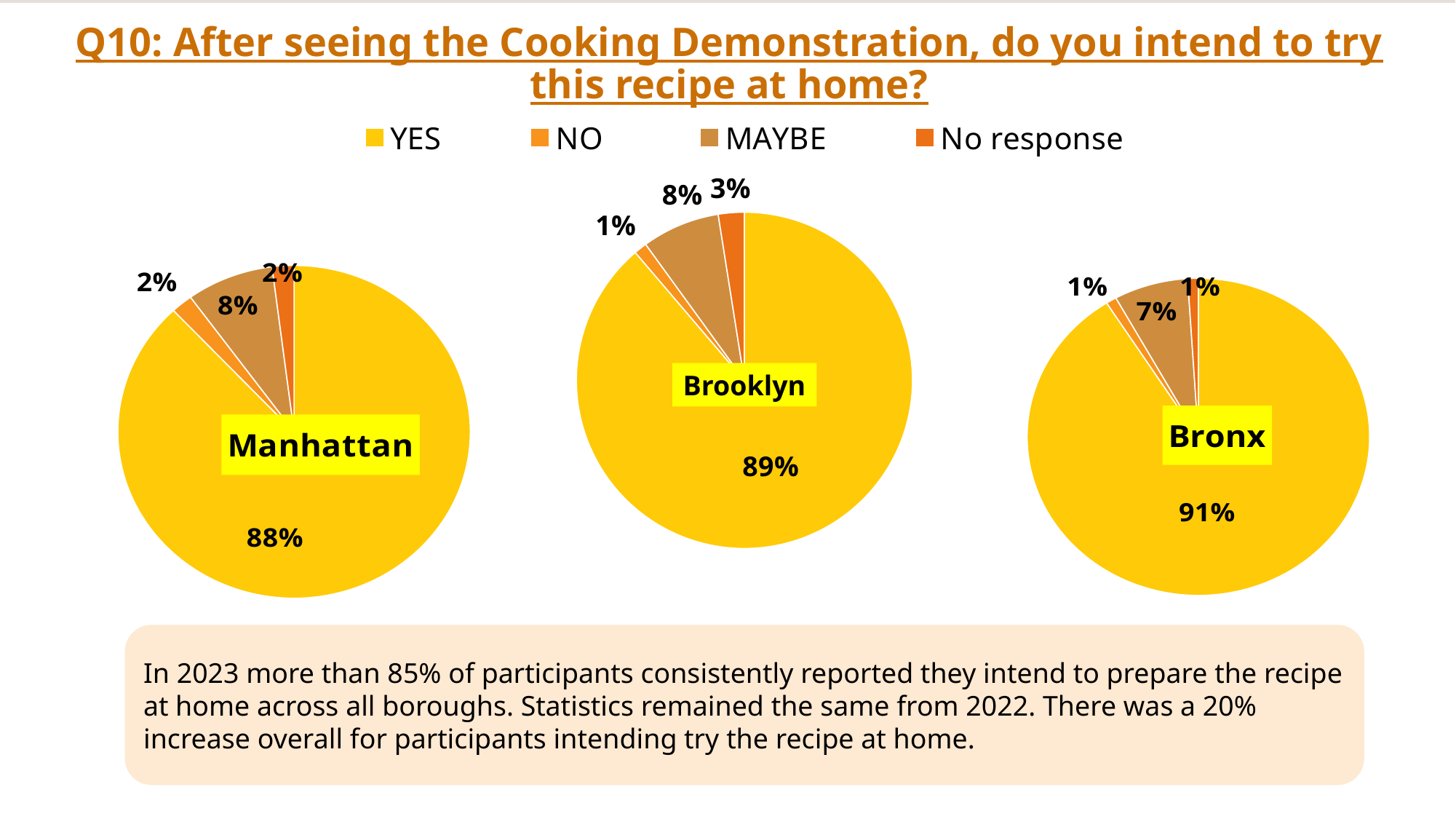
In the Brooklyn pie chart, what share of participants gave No response? 3% What kind of charts are shown on the slide? Pie charts In the Bronx pie chart, what share of participants answered MAYBE? 7% In the Bronx pie chart, what share of participants answered YES? 91% In the Manhattan pie chart, what share of participants answered YES? 88% What is the difference between the YES share in the Bronx pie chart and the YES share in the Manhattan pie chart? 3% In the Brooklyn pie chart, what share of participants answered YES? 89% In the Manhattan pie chart, what share of participants answered MAYBE? 8% Which category is shown in yellow in the legend? YES How many pie charts are on the slide? 3 Which borough's pie chart has the largest YES share? Bronx How many categories does the legend list? 4